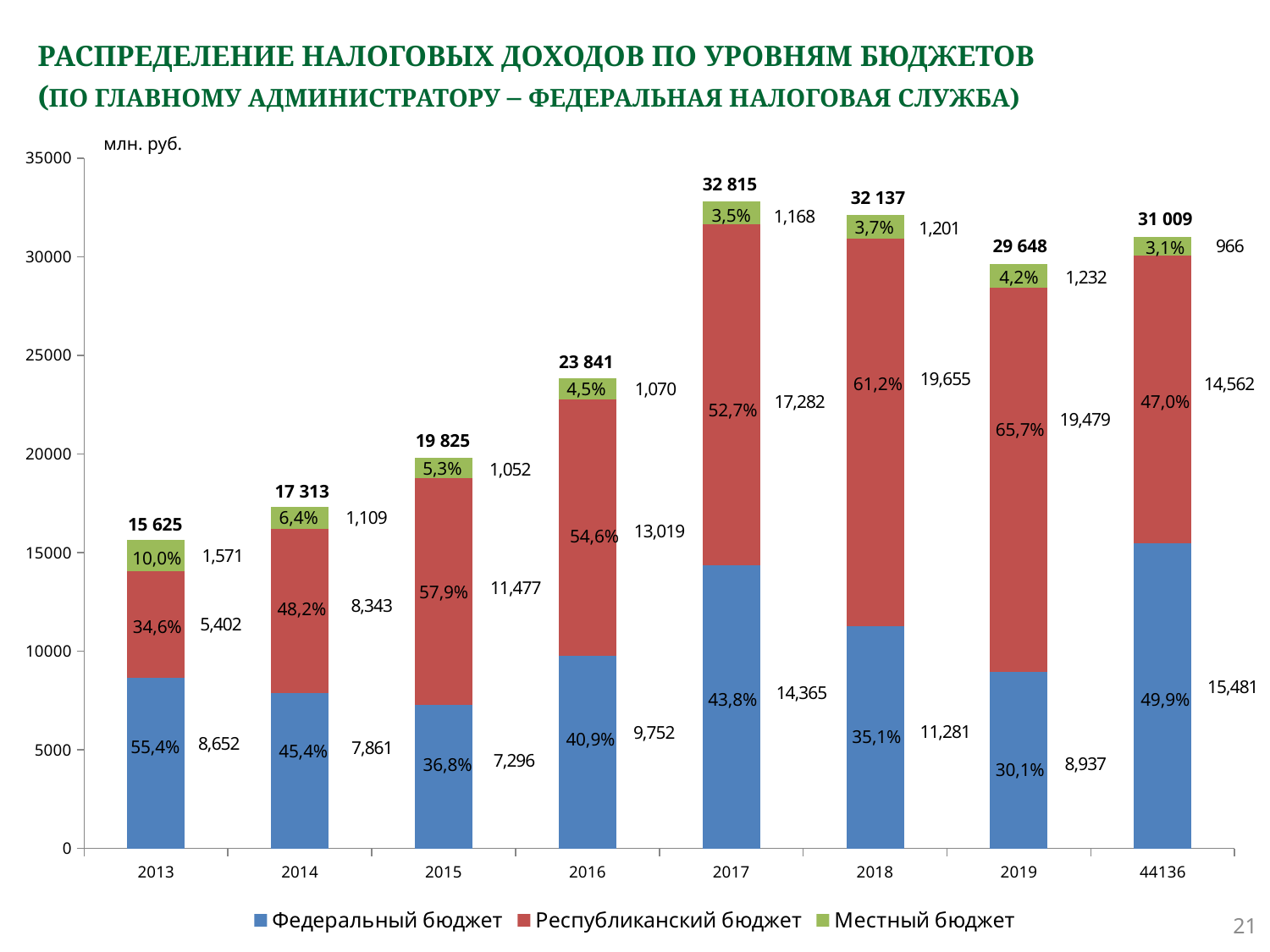
Do the total values rise or fall from 2013 to 2017? Rise What percentage share does Местный бюджет have in 2013? 10,0% What is the total of the stacked bar for 2019? 29 648 Which year has the highest total tax revenue? 2017 Which year has the lowest total tax revenue? 2013 Which is larger: Республиканский бюджет in 2018 or in 2019? 2018 How many series does the legend list? 3 How many stacked bars are shown on the chart? 8 What is the difference between the totals for 2017 and 2018? 678 What kind of chart is shown on the slide? Stacked bar chart What is the value for Федеральный бюджет in 2017? 14,365 What is the value for Республиканский бюджет in 2016? 13,019